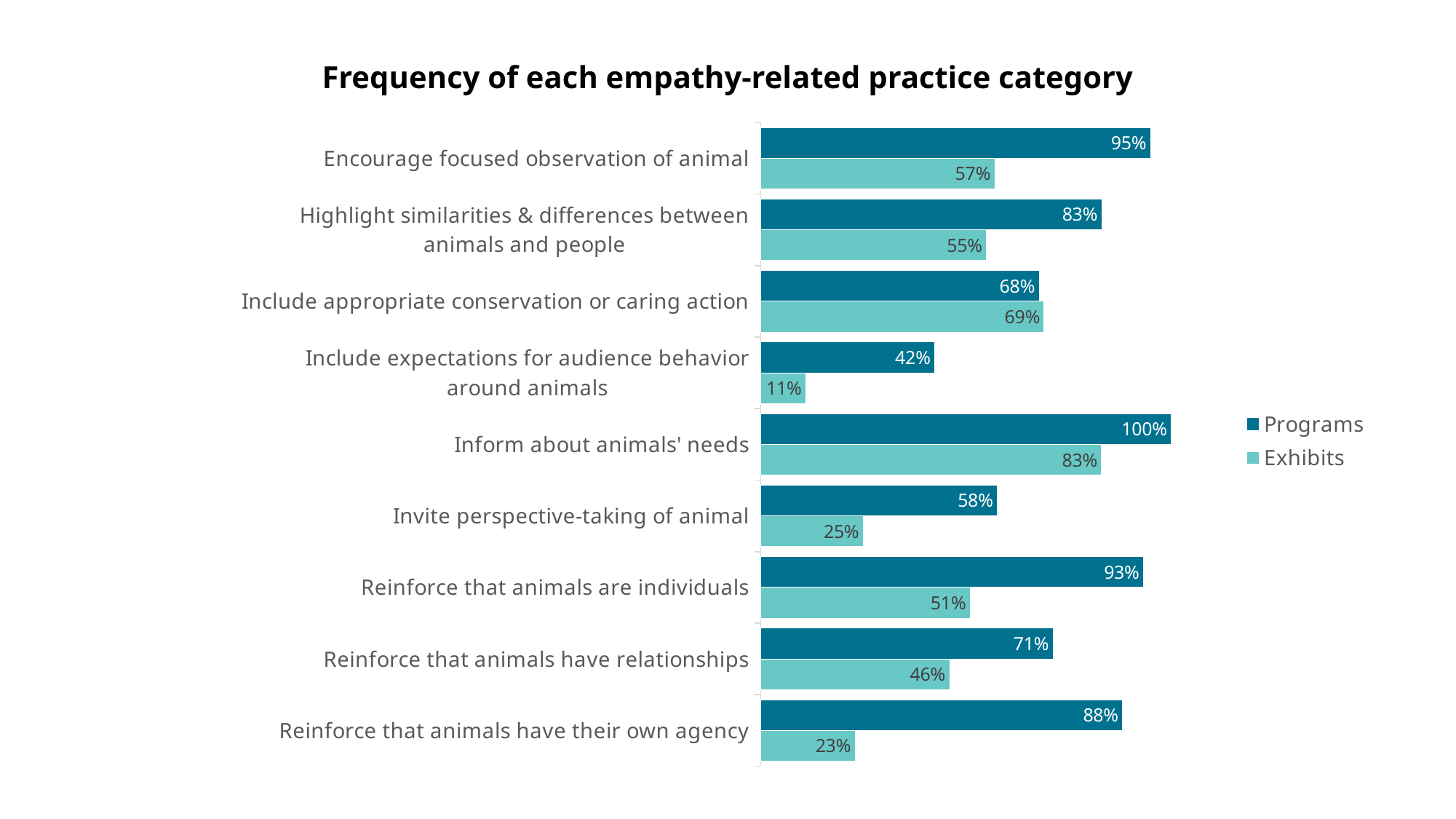
What is the Exhibits value for "Include expectations for audience behavior around animals"? 11% What is the Exhibits value for "Reinforce that animals have their own agency"? 23% Which category has the highest Programs value? Inform about animals' needs What kind of chart is shown on the slide? Bar chart What is the title of the chart? Frequency of each empathy-related practice category Which series is shown in the lighter teal colour? Exhibits Which category has the lowest Exhibits value? Include expectations for audience behavior around animals For "Include appropriate conservation or caring action", which is larger: the Programs value or the Exhibits value? Exhibits How many practice categories are shown on the chart? 9 How many series does the legend list? 2 What is the Programs value for "Inform about animals' needs"? 100% What is the difference between the Programs and Exhibits values for "Reinforce that animals have their own agency"? 65%